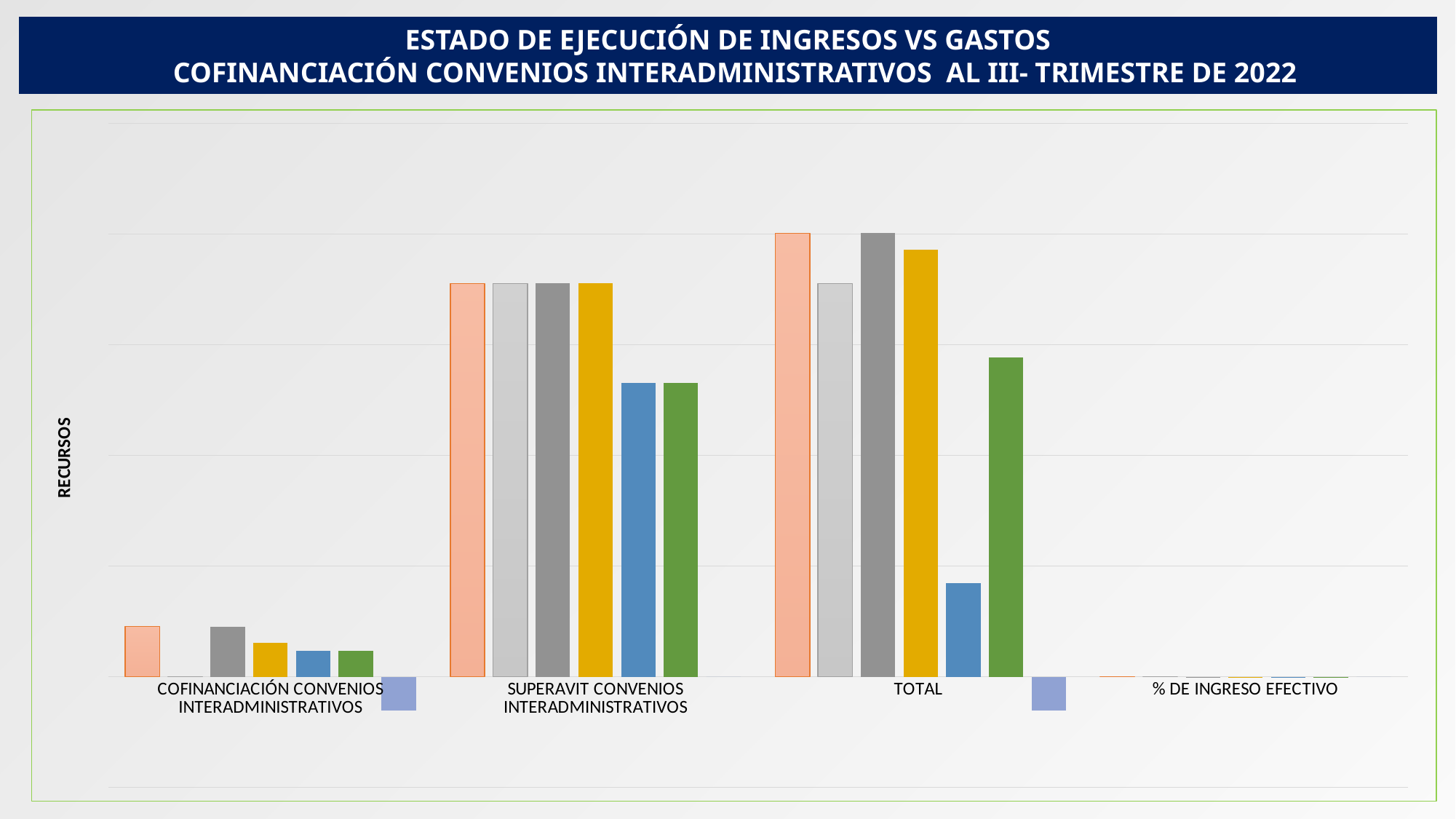
How many categories are shown on the x axis of the chart? 4 Are the bars for SUPERAVIT CONVENIOS INTERADMINISTRATIVOS taller or shorter than the bars for COFINANCIACIÓN CONVENIOS INTERADMINISTRATIVOS? Taller What kind of chart is shown on the slide? Bar chart What is the title shown above the chart? ESTADO DE EJECUCIÓN DE INGRESOS VS GASTOS COFINANCIACIÓN CONVENIOS INTERADMINISTRATIVOS AL III- TRIMESTRE DE 2022 In the SUPERAVIT CONVENIOS INTERADMINISTRATIVOS category, is the orange bar or the blue bar taller? Orange Which category is listed last on the x axis of the chart? % DE INGRESO EFECTIVO Which category has the smallest bars in the chart? % DE INGRESO EFECTIVO What is the label on the vertical axis of the chart? RECURSOS Which category contains the tallest bar in the chart? TOTAL In the TOTAL category, is the green bar or the blue bar taller? Green